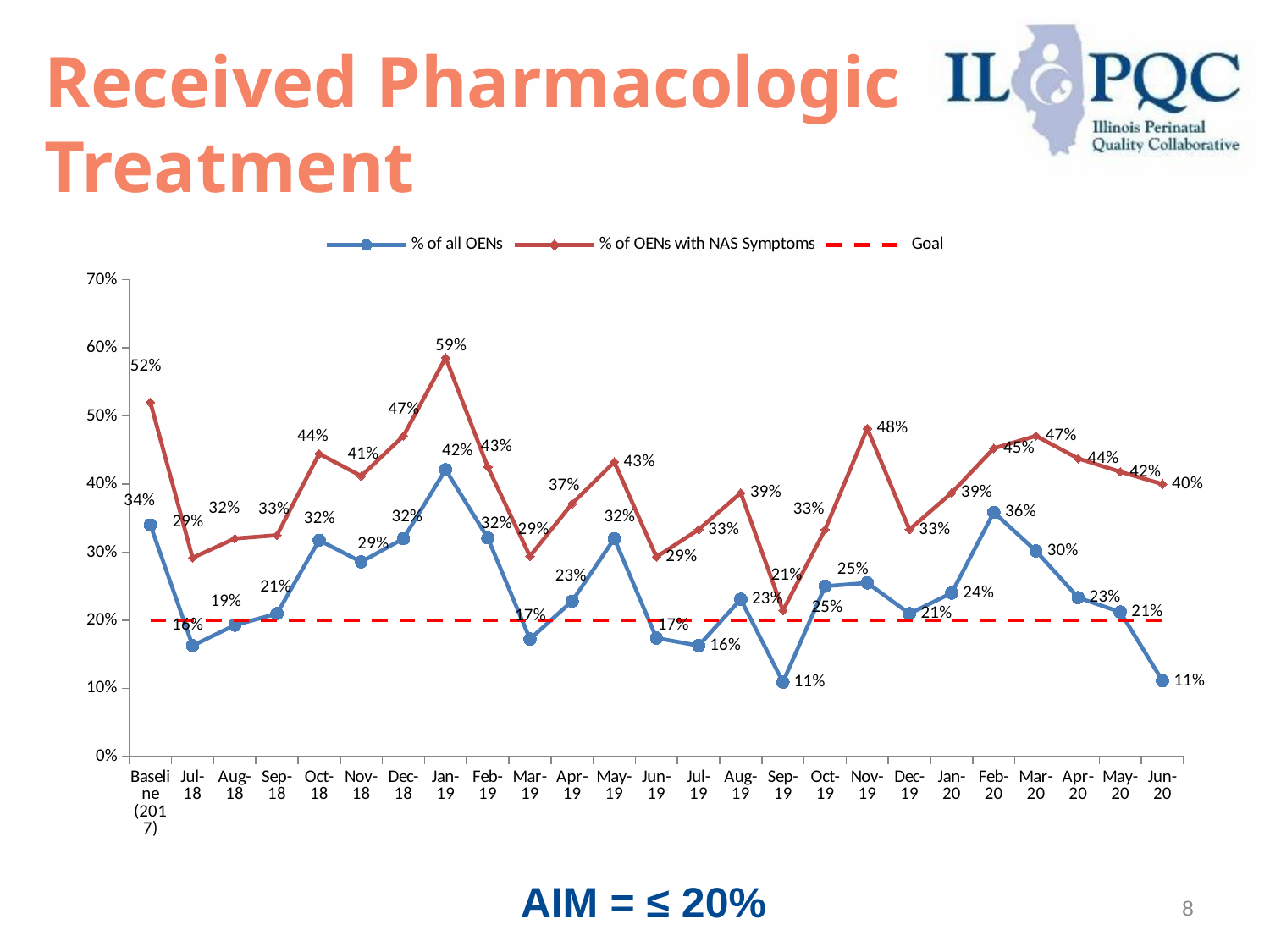
In Jan-19, what is the difference between the % of OENs with NAS Symptoms and the % of all OENs? 17 percentage points In which month is the % of OENs with NAS Symptoms highest? Jan-19 At what value is the Goal line drawn? 20% What type of chart is shown on the slide? line chart What is the % of OENs with NAS Symptoms for Jan-19? 59% In which month is the % of OENs with NAS Symptoms lowest? Sep-19 How many series does the legend list? 3 What is the % of all OENs at Baseline (2017)? 34% What is the % of all OENs for Jun-20? 11% What is the title of the slide? Received Pharmacologic Treatment Which is larger: the % of OENs with NAS Symptoms in Oct-18 or in Dec-18? Dec-18 How many time points are plotted along the x axis? 25